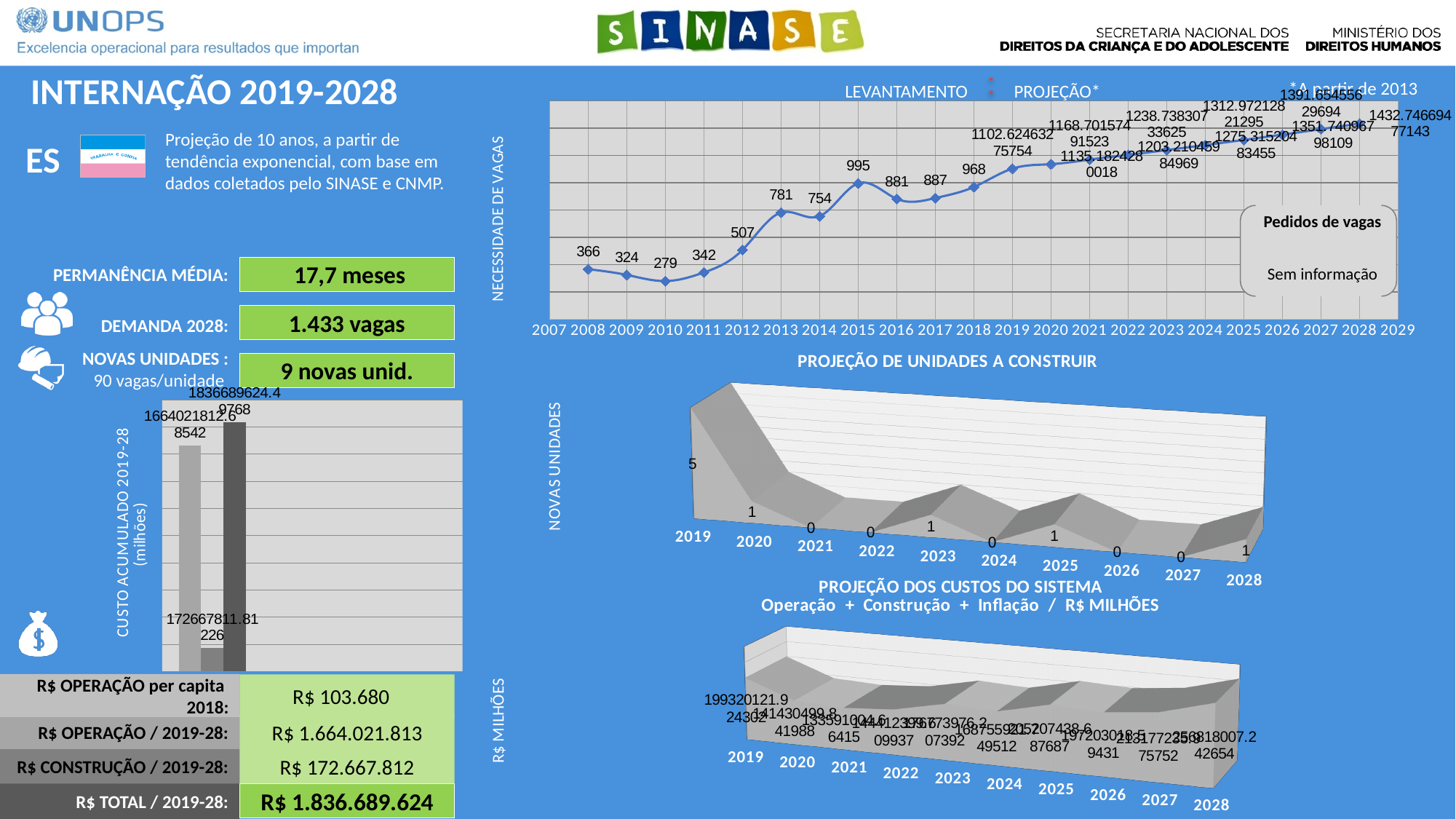
What kind of chart is the NECESSIDADE DE VAGAS chart at the top right? line chart In the NECESSIDADE DE VAGAS line chart, what is the difference between the values for 2015 and 2014? 241 In the NECESSIDADE DE VAGAS line chart, what is the value for 2018? 968 In the NECESSIDADE DE VAGAS line chart, which is larger, the value for 2013 or the value for 2014? 2013 In the NECESSIDADE DE VAGAS line chart, what is the value for 2015? 995 In the NECESSIDADE DE VAGAS line chart, what is the value for 2008? 366 How many years are shown on the x axis of the PROJEÇÃO DE UNIDADES A CONSTRUIR chart? 10 In the PROJEÇÃO DE UNIDADES A CONSTRUIR chart, what is the value for 2019? 5 In the PROJEÇÃO DE UNIDADES A CONSTRUIR chart, which year has the highest value? 2019 In the NECESSIDADE DE VAGAS line chart, which year has the lowest value? 2010 In the NECESSIDADE DE VAGAS line chart, do the values rise or fall from 2019 to 2028? rise